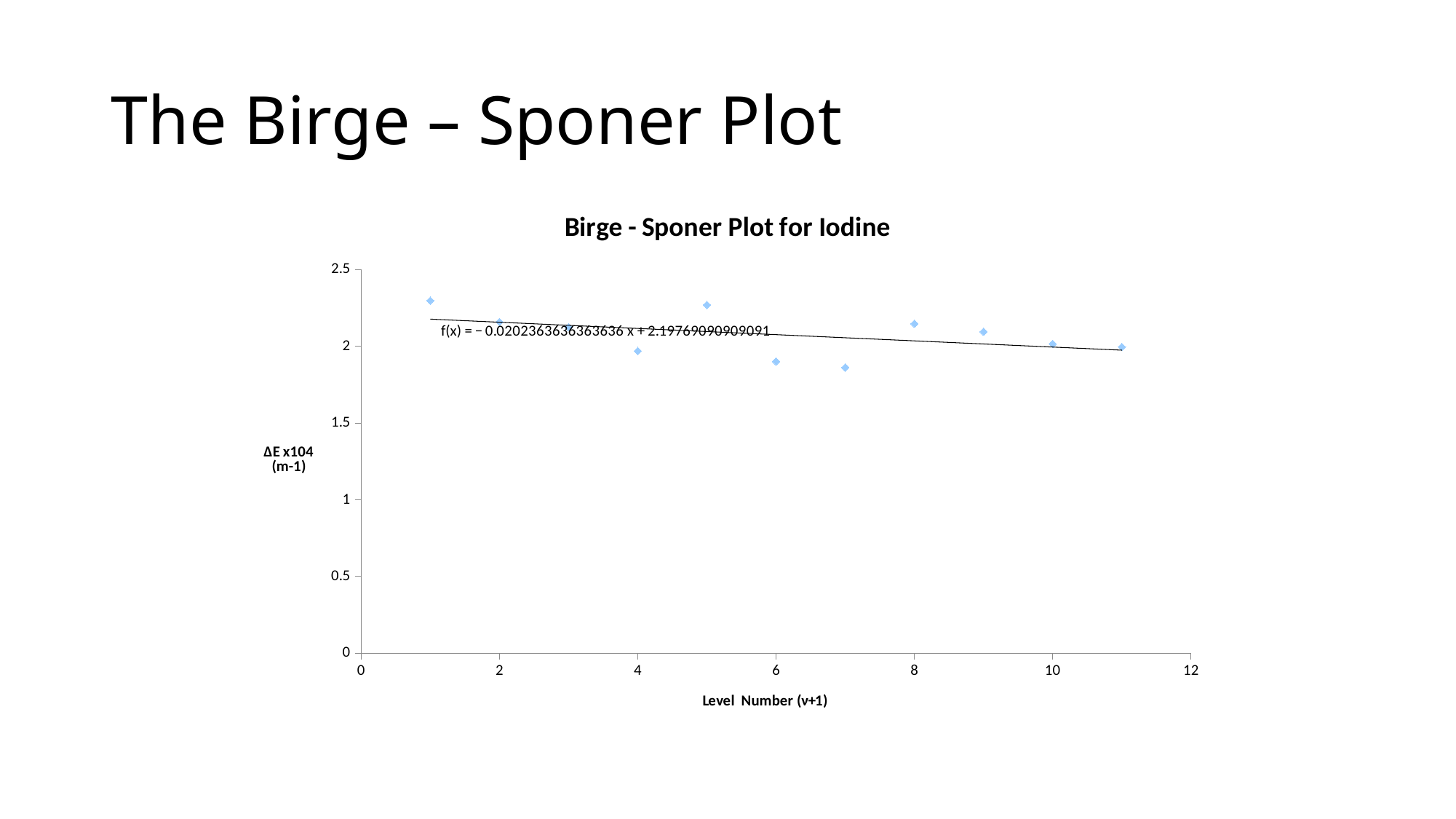
According to the fitted trendline, do the values rise or fall as the level number increases? Fall What is the title of the chart? Birge - Sponer Plot for Iodine What is the label of the x axis? Level Number (v+1) Is the value at level number 5 greater or less than 2? greater How many data points are plotted on the chart? 11 Is the value at level number 6 greater or less than 2? less Is the value at level number 7 greater or less than 2? less What kind of chart is shown on the slide? Scatter plot Which has the larger value, level number 5 or level number 6? Level number 5 Which has the larger value, level number 1 or level number 7? Level number 1